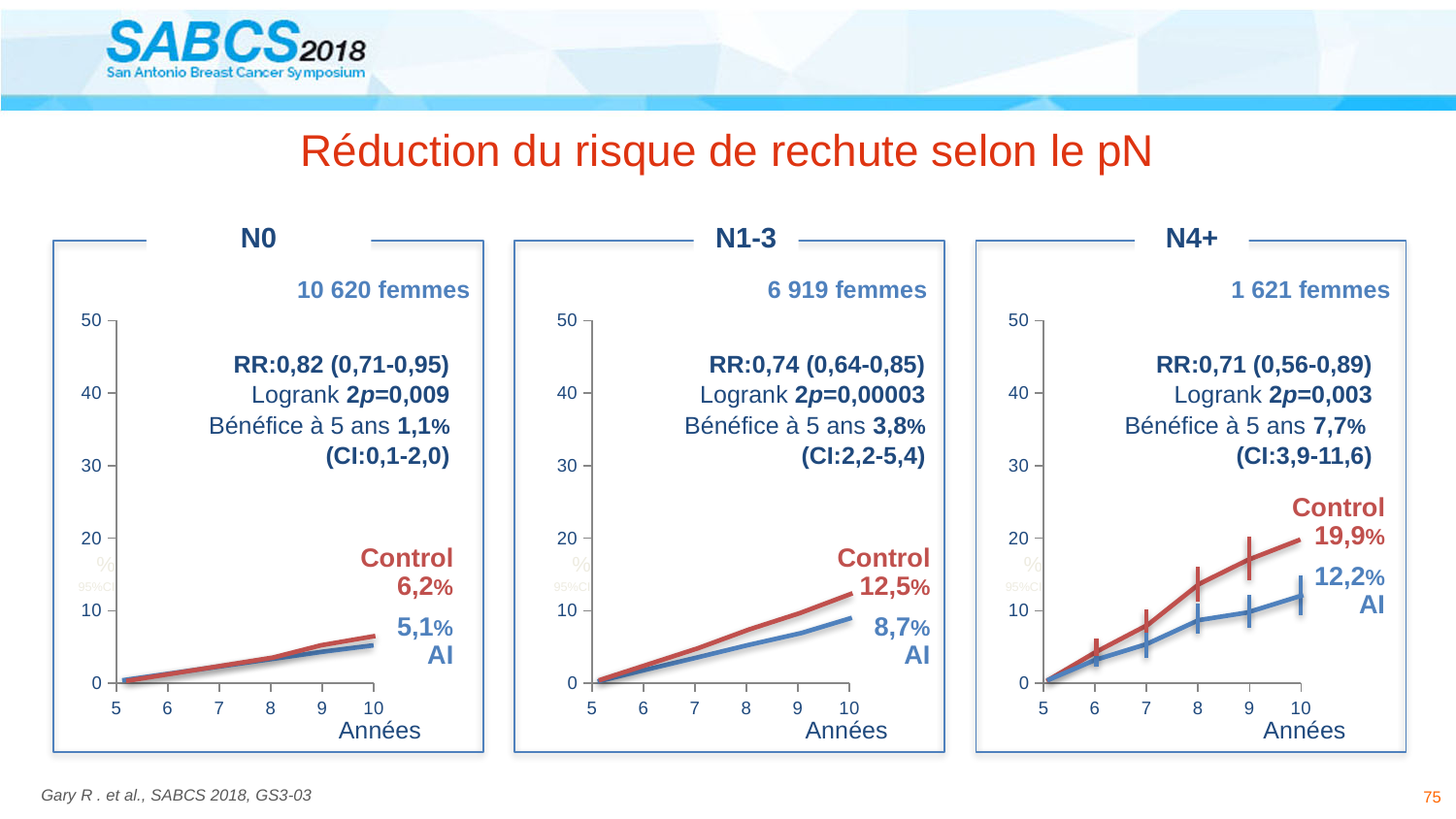
How many series are plotted in the N0 chart? 2 In the N0 chart, what is the value for AI at 10 years? 5,1% In the N0 chart, what is the value for Control at 10 years? 6,2% In the N1-3 chart, what is the difference between the Control and AI values at 10 years? 3,8% In the N4+ chart, is the Control value at 10 years greater or less than 10? greater In the N4+ chart, do the values rise or fall from 5 to 10 years? Rise In the N1-3 chart, what is the value for Control at 10 years? 12,5% What kind of chart is the N1-3 chart? Line chart In the N4+ chart, which line is higher at 10 years, Control or AI? Control How many women are included in the N1-3 chart? 6 919 femmes In the N4+ chart, what is the difference between the Control and AI values at 10 years? 7,7% In the N4+ chart, what is the value for AI at 10 years? 12,2%